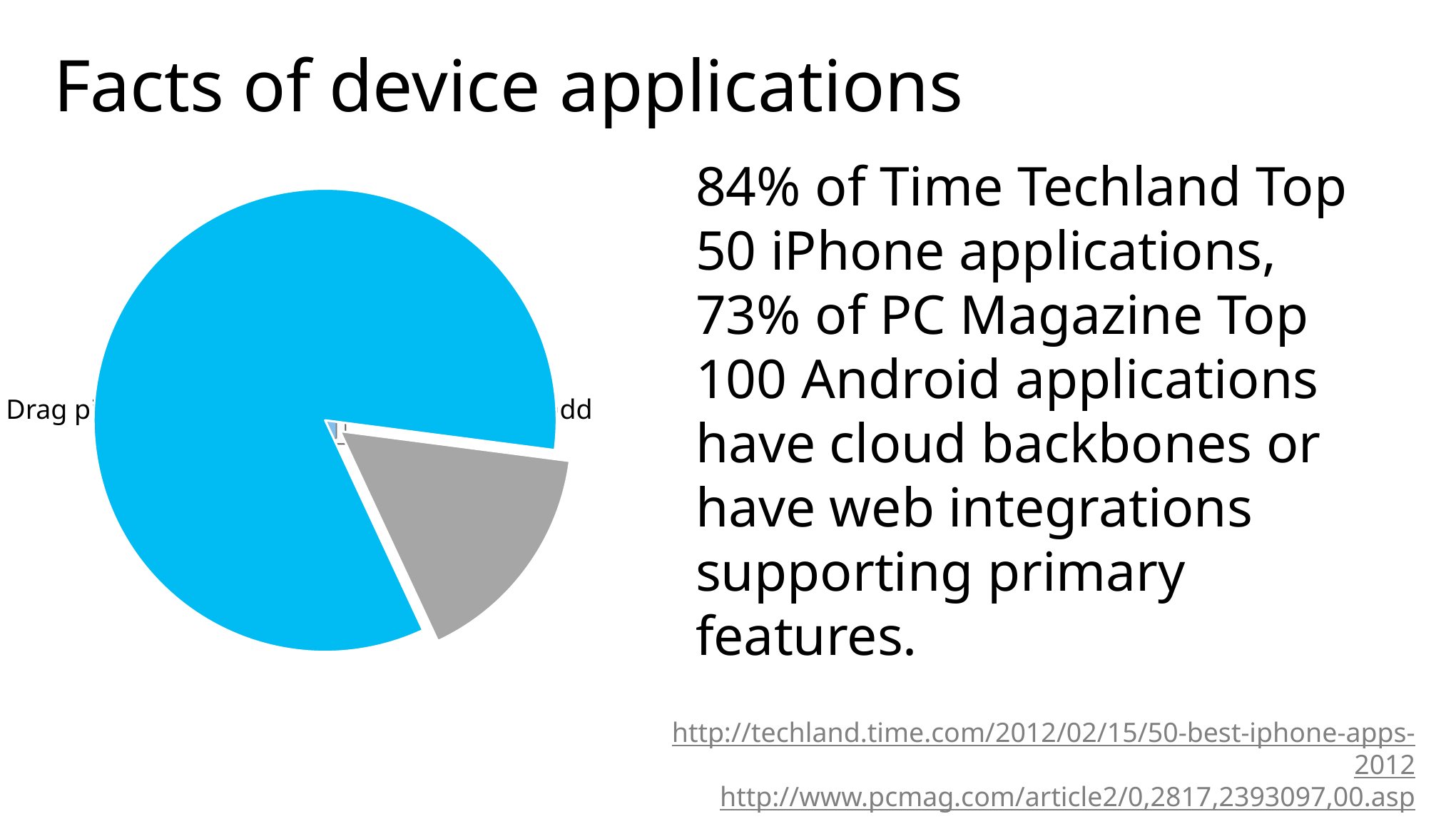
Which slice of the pie chart is pulled out (exploded) from the rest of the pie? the gray slice What kind of chart is shown on the slide? pie chart What two colours are used for the slices of the pie chart? blue and gray Is the blue slice of the pie chart larger or smaller than the gray slice? larger How many slices does the pie chart have? 2 Which slice of the pie chart is the smallest, the blue one or the gray one? the gray one Which slice of the pie chart is the largest, the blue one or the gray one? the blue one